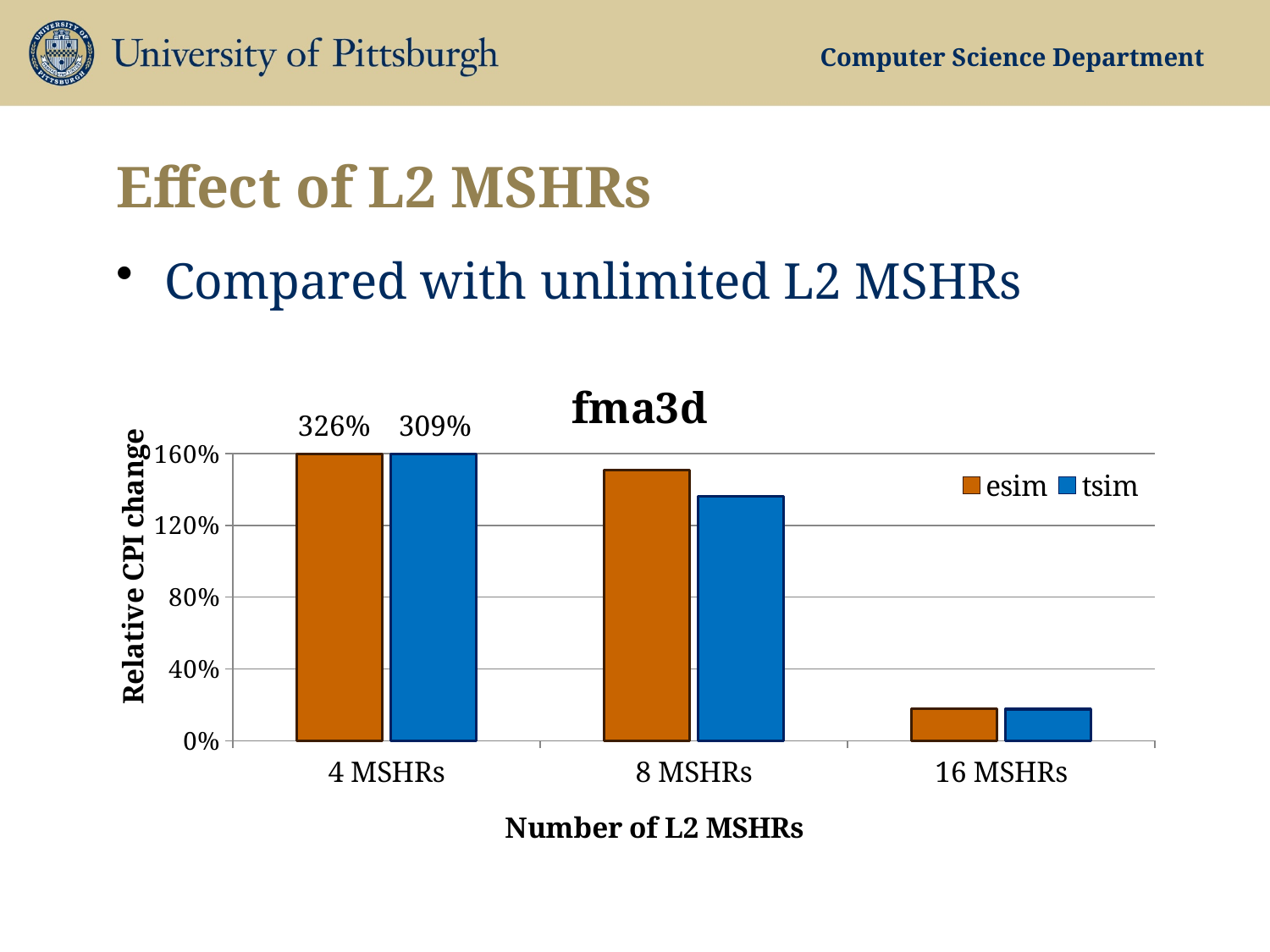
Which number of L2 MSHRs has the highest esim value? 4 MSHRs At 8 MSHRs, which series has the larger value, esim or tsim? esim Is the value for esim at 16 MSHRs greater or less than 40%? less How many series does the legend list? 2 What is the difference between the esim and tsim values at 4 MSHRs? 17% Which number of L2 MSHRs has the lowest tsim value? 16 MSHRs How many categories are shown on the x axis? 3 What is the value for tsim at 4 MSHRs? 309% What is the value for esim at 4 MSHRs? 326% Do the esim values rise or fall as the number of L2 MSHRs increases? fall Is the value for tsim at 8 MSHRs greater or less than 120%? greater What kind of chart is shown? bar chart